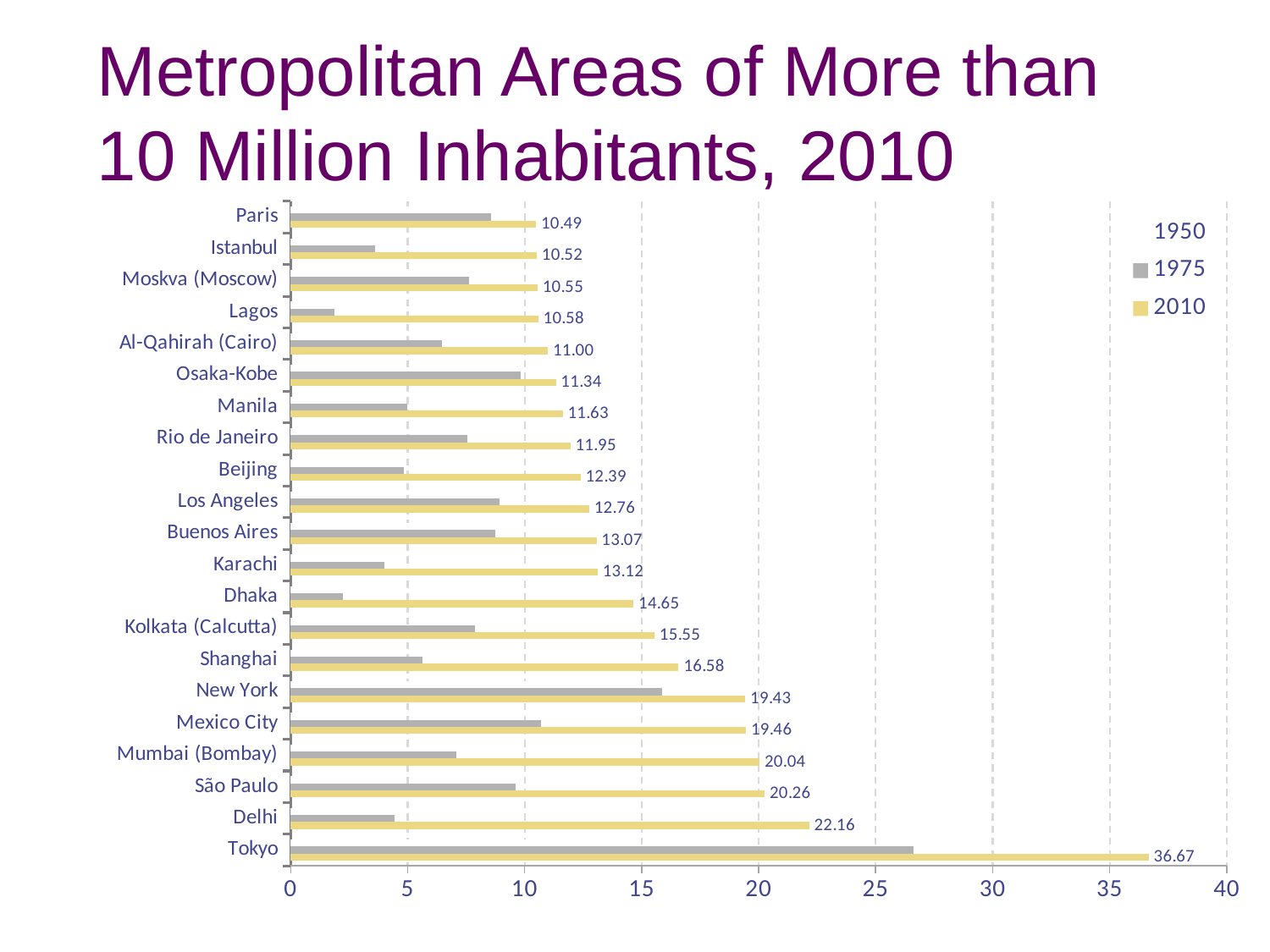
What is the difference between the 2010 values for Mumbai (Bombay) and New York? 0.61 What is the 2010 value for Tokyo? 36.67 What kind of chart is shown on the slide? bar chart Which has the larger 2010 value, Dhaka or Kolkata (Calcutta)? Kolkata (Calcutta) What is the 2010 value for Shanghai? 16.58 Is the 1975 value for Lagos greater or less than 5? less How many series does the legend list? 3 How many metropolitan areas are listed on the chart? 21 Which metropolitan area has the lowest 2010 value? Paris What is the 2010 value for Delhi? 22.16 What is the difference between the 2010 values for Tokyo and Delhi? 14.51 Which metropolitan area has the highest 2010 value? Tokyo